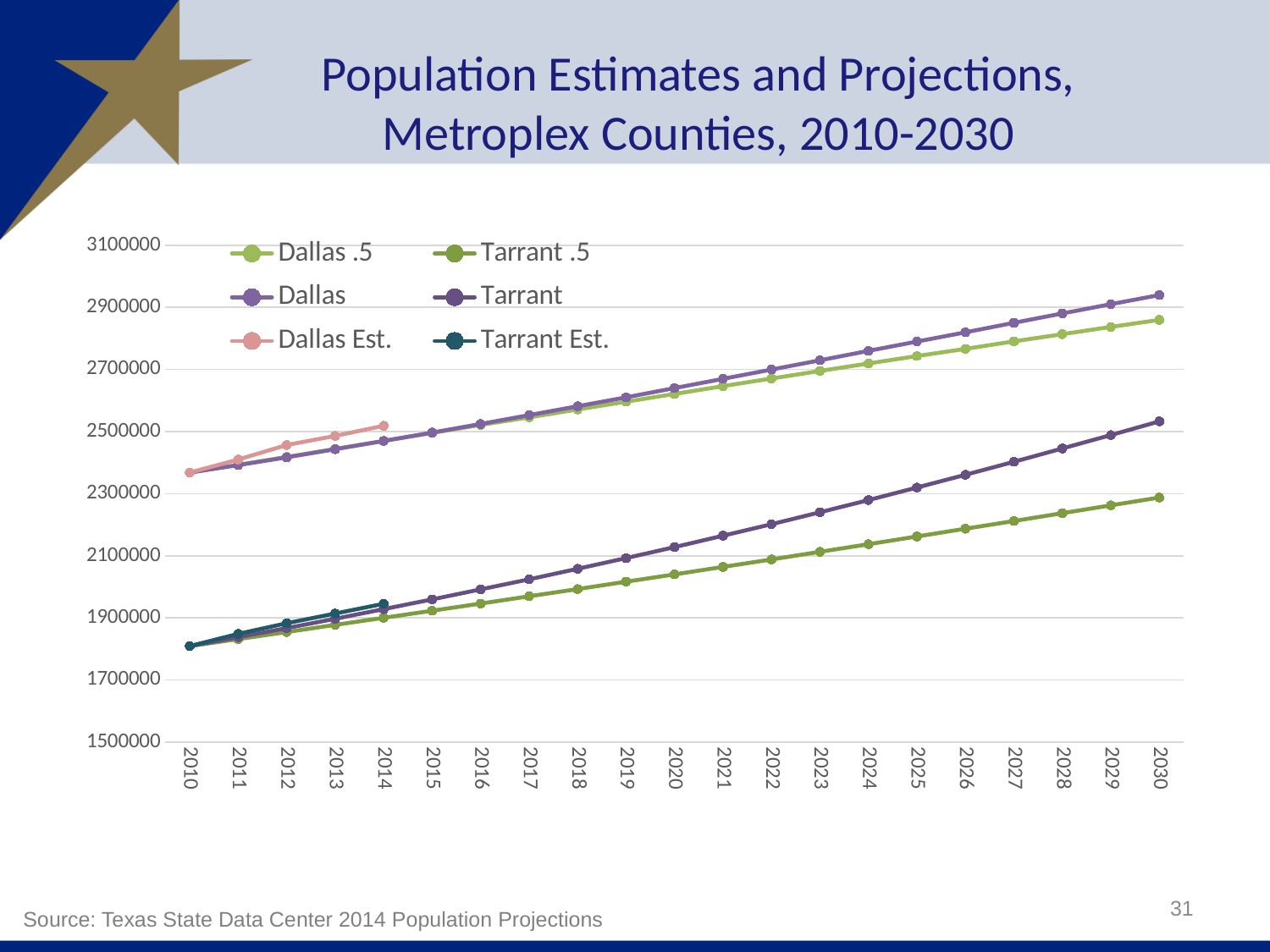
Does the Tarrant .5 series rise or fall from 2010 to 2030? rise Which series has the lowest value in 2030? Tarrant .5 What is the title of the chart? Population Estimates and Projections, Metroplex Counties, 2010-2030 Is the value for Tarrant in 2010 greater or less than 1900000? less In 2030, which is larger, the Dallas value or the Tarrant value? Dallas Does the Dallas series rise or fall from 2010 to 2030? rise What kind of chart is shown on the slide? line chart Is the value for Tarrant .5 in 2030 greater or less than 2500000? less How many years are shown along the x axis? 21 How many series does the legend list? 6 Is the value for Dallas in 2030 greater or less than 2700000? greater Which series has the highest value in 2030? Dallas